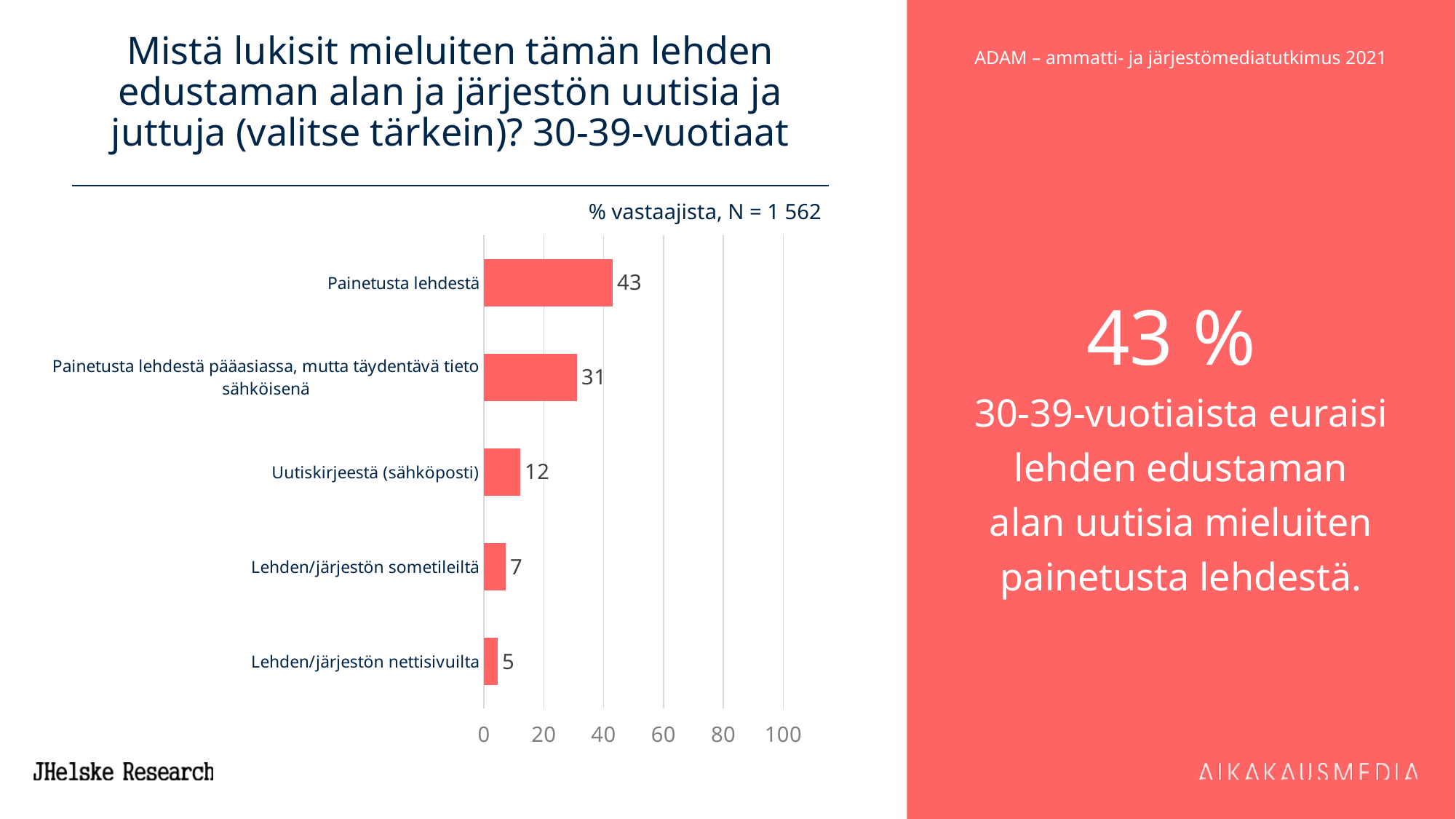
What is the value for "Uutiskirjeestä (sähköposti)"? 12 Which category has the lowest value? Lehden/järjestön nettisivuilta Is the value for "Painetusta lehdestä" greater or less than 40? greater What kind of chart is shown on the slide? Bar chart What is the difference between the values for "Painetusta lehdestä" and "Painetusta lehdestä pääasiassa, mutta täydentävä tieto sähköisenä"? 12 What is the value for "Painetusta lehdestä"? 43 How many categories are shown in the chart? 5 What is the value for "Painetusta lehdestä pääasiassa, mutta täydentävä tieto sähköisenä"? 31 Which is larger: the value for "Lehden/järjestön sometileiltä" or "Lehden/järjestön nettisivuilta"? Lehden/järjestön sometileiltä What is the value for "Lehden/järjestön nettisivuilta"? 5 What is the unit label shown above the chart? % vastaajista, N = 1 562 Which category has the highest value? Painetusta lehdestä